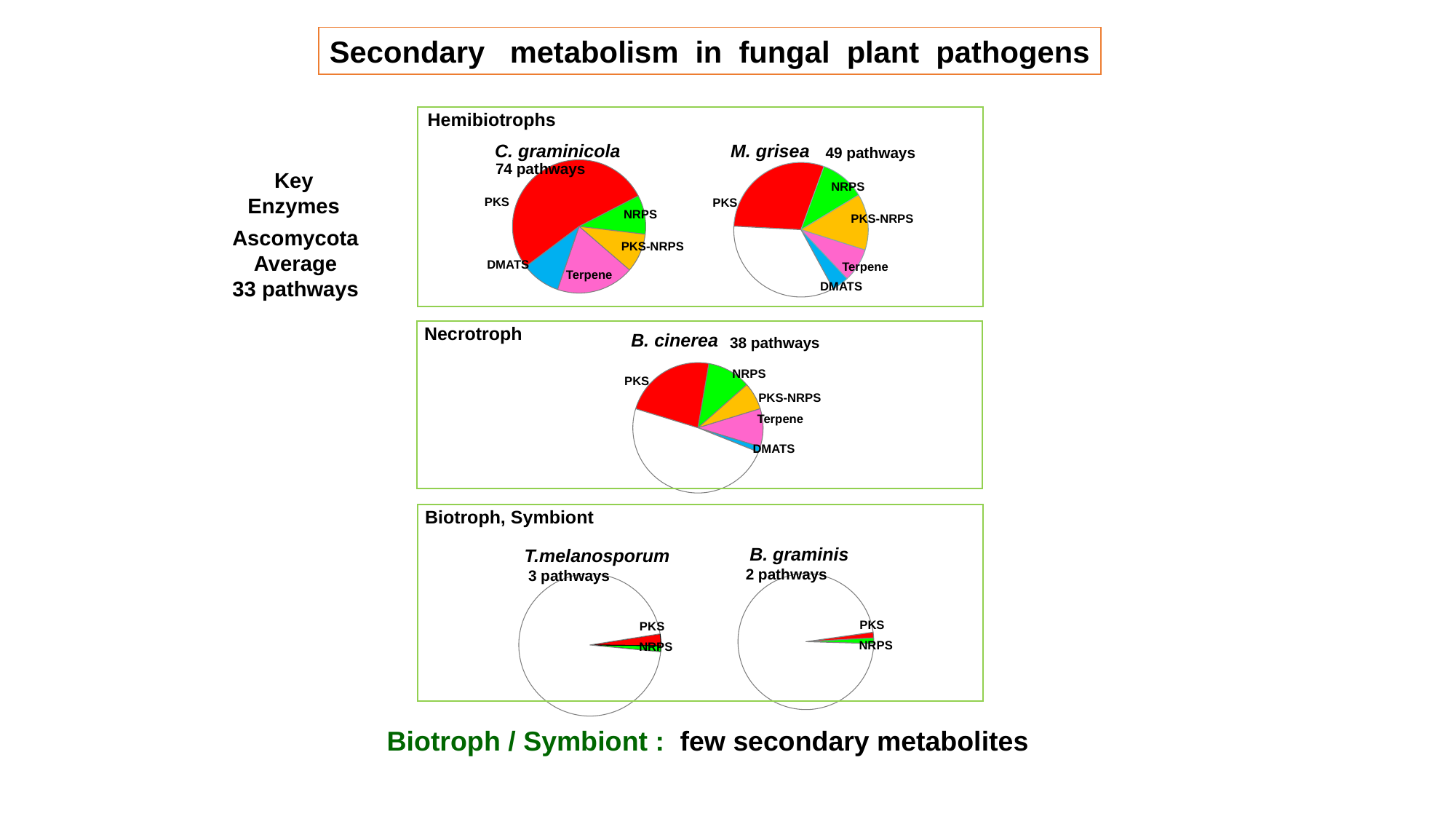
In the M. grisea pie chart, which slice is larger, PKS or DMATS? PKS How many pathways are shown for B. graminis? 2 pathways How many pathways are shown for B. cinerea? 38 pathways How many enzyme classes are labelled in the B. cinerea pie chart? 5 Which species has the most pathways among the five pie charts? C. graminicola What kind of chart is used for C. graminicola? pie chart What is the difference in the number of pathways between C. graminicola and M. grisea? 25 In the C. graminicola pie chart, which enzyme class has the largest slice? PKS How many pathways are shown for C. graminicola? 74 pathways Which species has the fewest pathways among the five pie charts? B. graminis How many pathways are shown for T. melanosporum? 3 pathways How many pathways are shown for M. grisea? 49 pathways